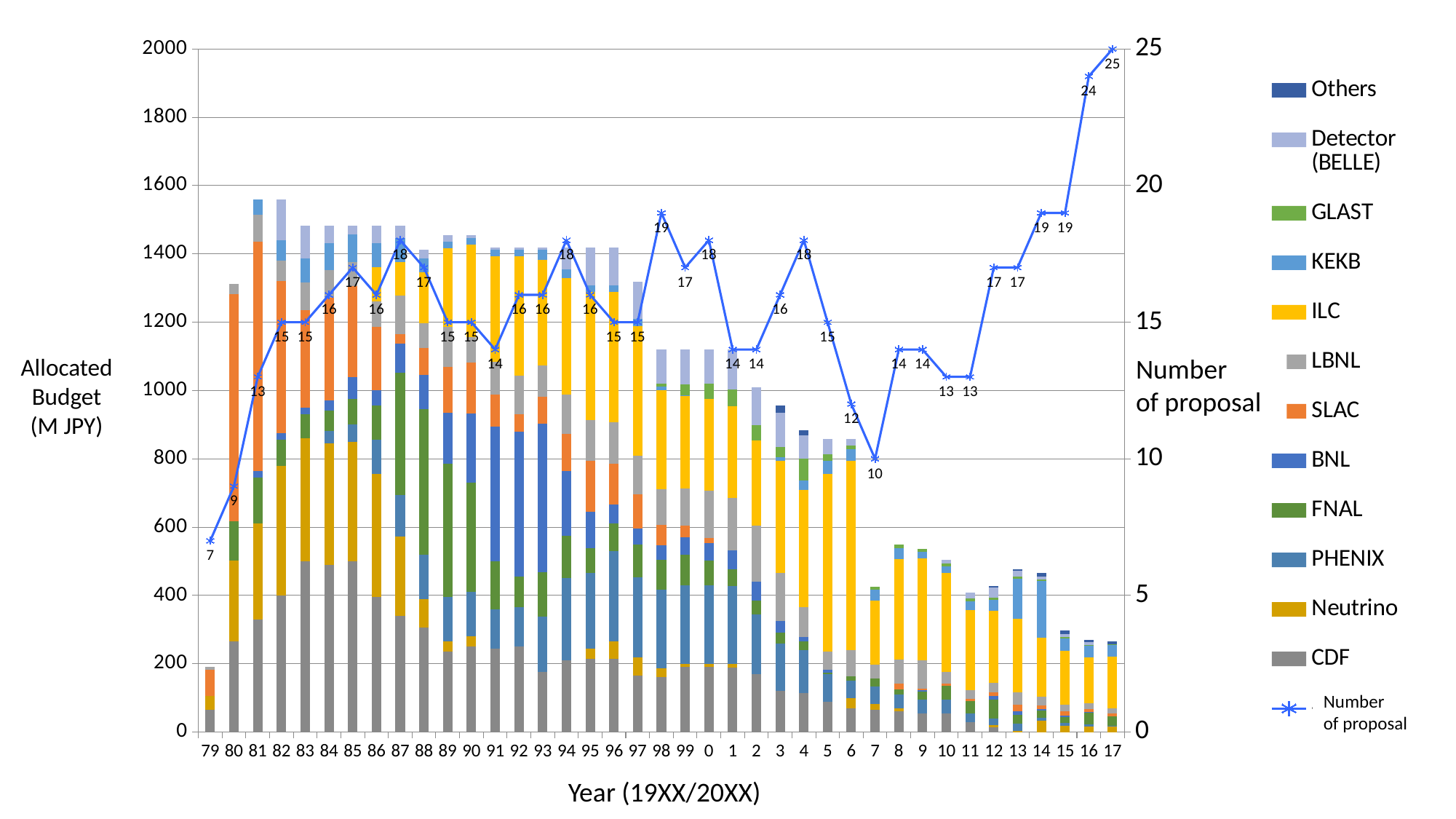
Which year has more proposals, 98 or 99? 98 How many years are shown on the x axis? 39 How many entries does the legend list? 13 How many proposals are shown for year 17? 25 What is the difference between the number of proposals in year 17 and in year 79? 18 What kind of chart is this? stacked bar chart with a line Is the total allocated budget bar for year 81 greater or less than 1400? greater Is the total allocated budget bar for year 17 greater or less than 400? less How many proposals are shown for year 7? 10 Which year has the highest number of proposals? 17 How many proposals are shown for year 79? 7 Which year has the lowest number of proposals? 79